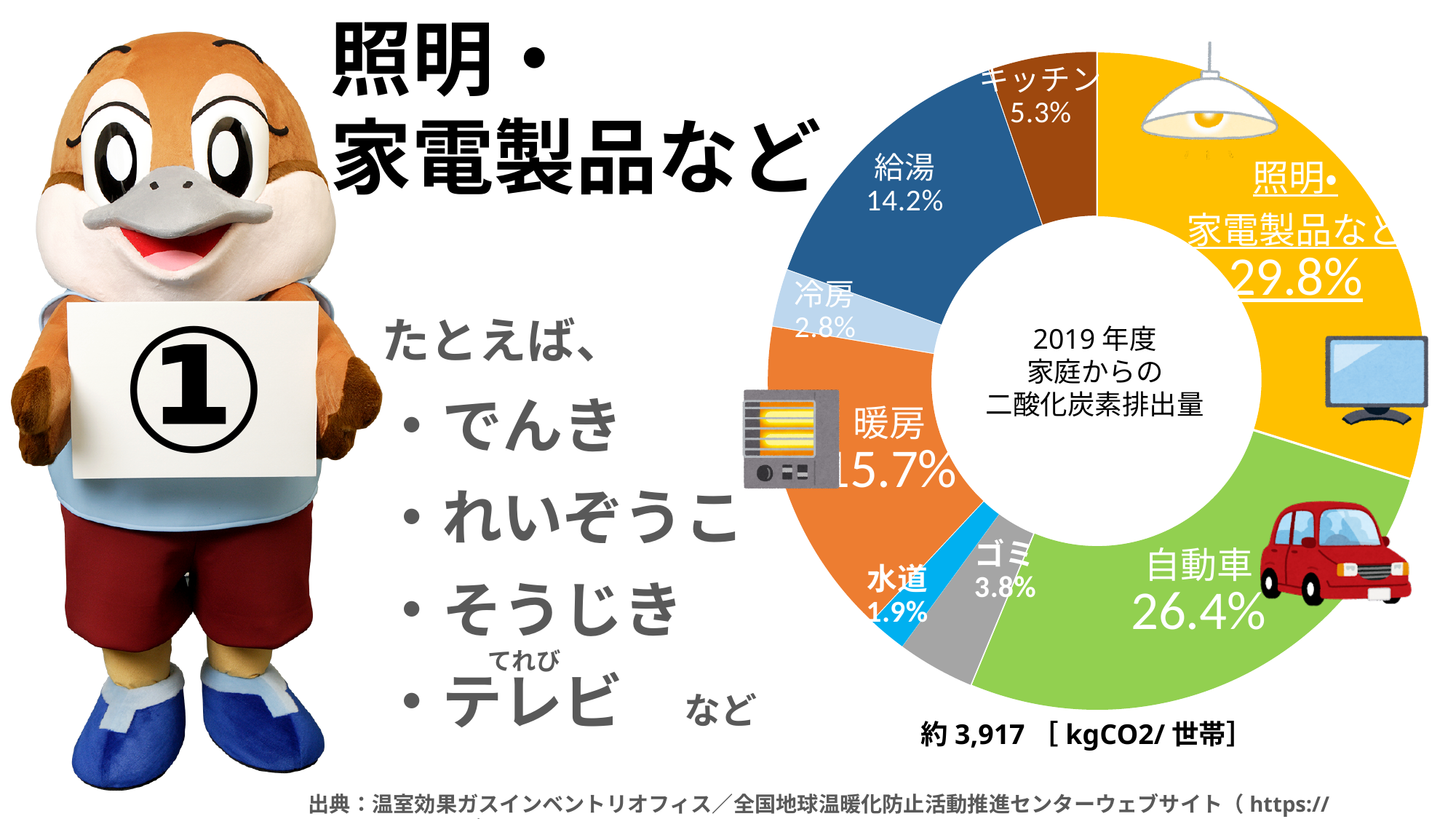
What total household CO2 emission value is printed below the chart? 約3,917 kgCO2/世帯 What share of household CO2 emissions comes from 照明・家電製品など? 29.8% Which category has the smallest share of household CO2 emissions? 水道 What is the difference in share between 照明・家電製品など and 自動車? 3.4% How many categories are shown in the pie chart? 8 What share of household CO2 emissions comes from 給湯? 14.2% What share of household CO2 emissions comes from 水道? 1.9% What kind of chart is shown on the slide? Pie chart (donut) Which has a larger share, キッチン or ゴミ? キッチン What share of household CO2 emissions comes from 暖房? 15.7% What share of household CO2 emissions comes from 自動車? 26.4% Which category has the largest share of household CO2 emissions? 照明・家電製品など